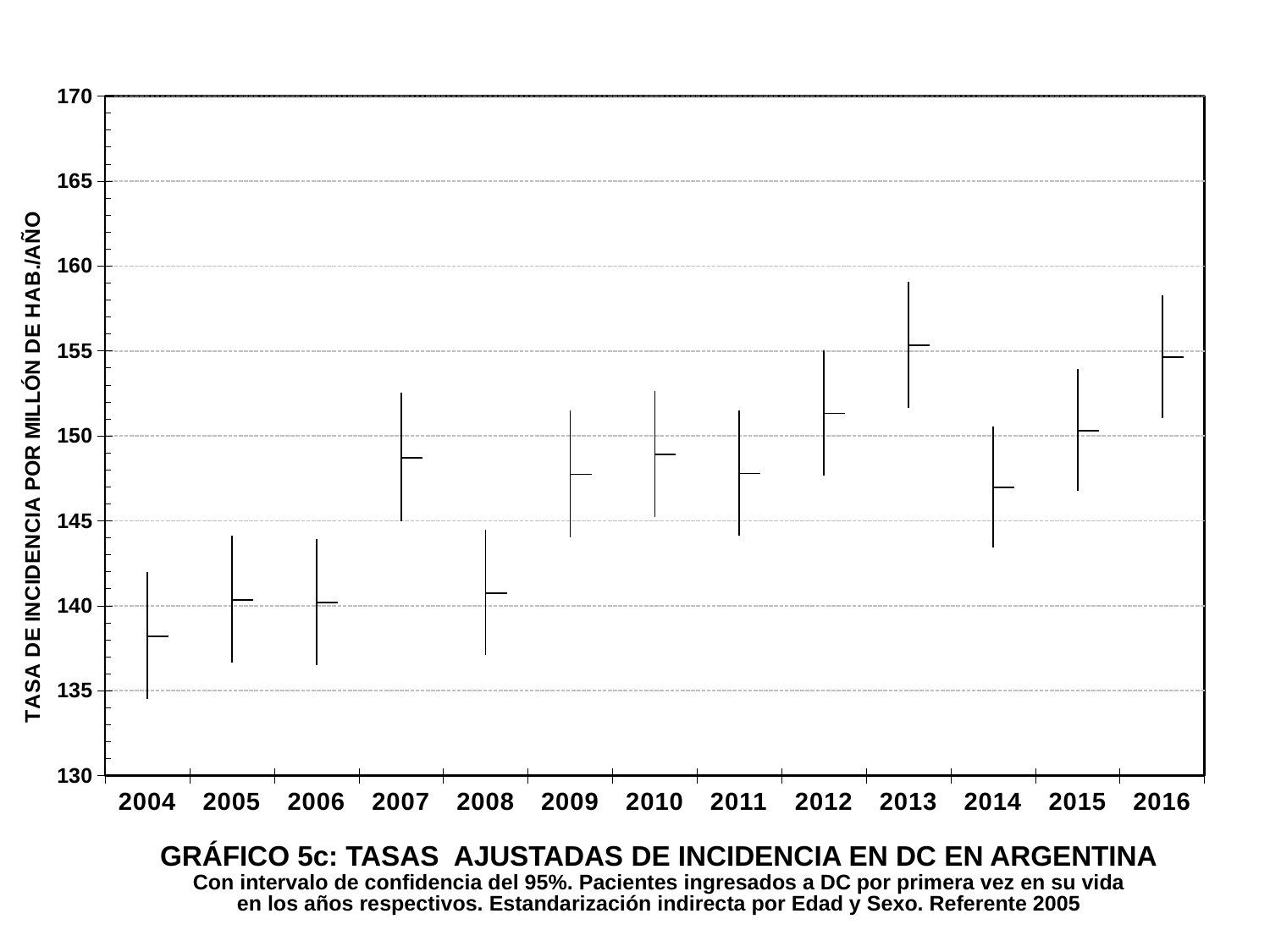
Do the incidence rates generally rise or fall from 2004 to 2016? rise What is the label of the y axis? TASA DE INCIDENCIA POR MILLÓN DE HAB./AÑO Which is larger, the value for 2013 or the value for 2004? 2013 Is the value for 2007 greater or less than 150? less How many years are plotted on the x axis of the chart? 13 Which is larger, the value for 2012 or the value for 2014? 2012 Is the value for 2013 greater or less than 150? greater Is the value for 2004 greater or less than 140? less What confidence level do the intervals shown in the chart represent? 95% Which year has the lowest adjusted incidence rate? 2004